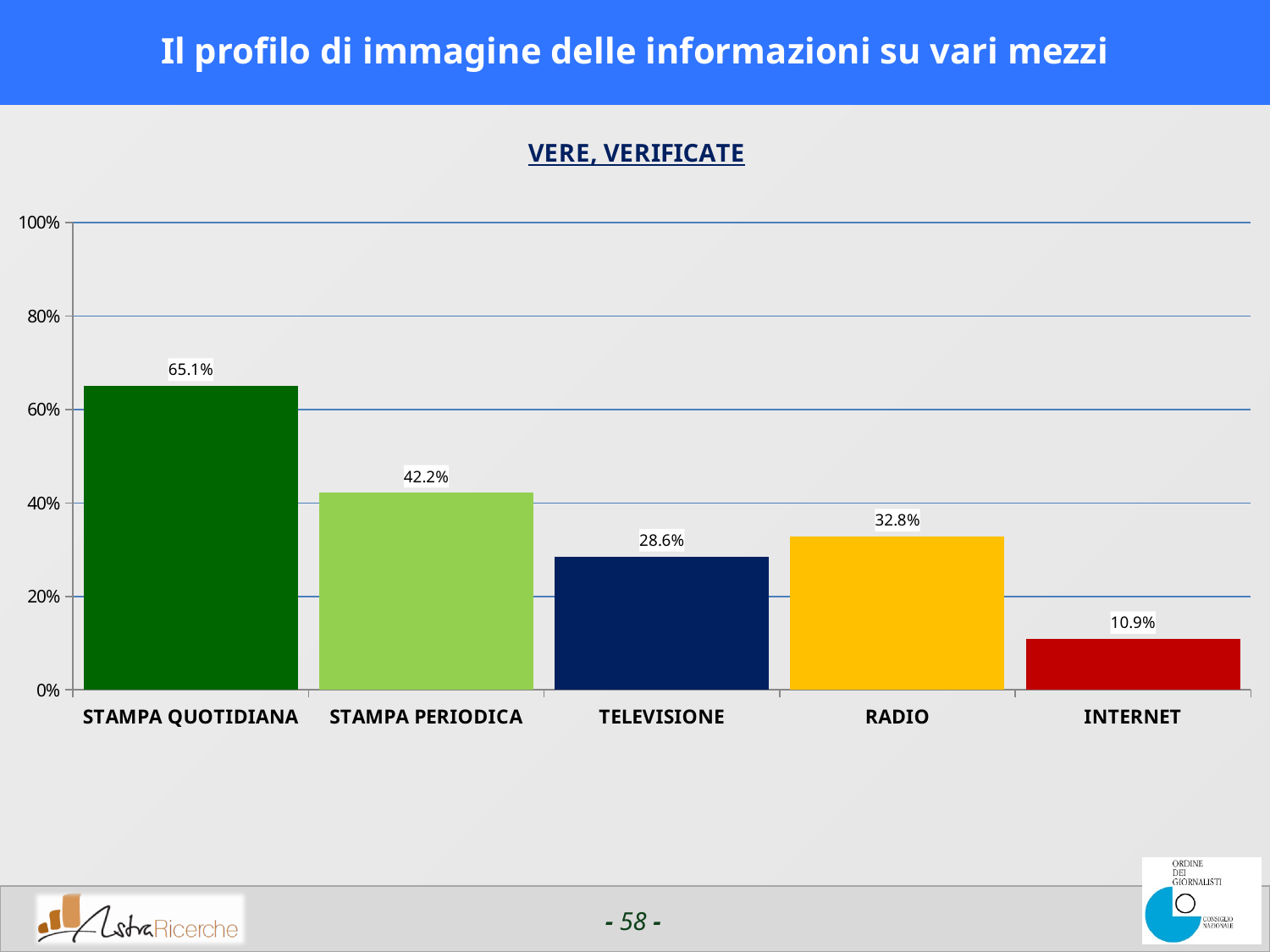
What is the difference between the values for RADIO and TELEVISIONE? 4.2% What is the value for INTERNET? 10.9% What is the value for TELEVISIONE? 28.6% What kind of chart is shown on the slide? bar chart Which is larger, the value for RADIO or the value for TELEVISIONE? RADIO What is the difference between the values for STAMPA QUOTIDIANA and STAMPA PERIODICA? 22.9% Is the value for STAMPA PERIODICA greater or less than 40%? greater Which category has the lowest value? INTERNET Which category has the highest value? STAMPA QUOTIDIANA What is the title shown above the chart? VERE, VERIFICATE What is the value for STAMPA QUOTIDIANA? 65.1% How many categories are shown on the x axis? 5